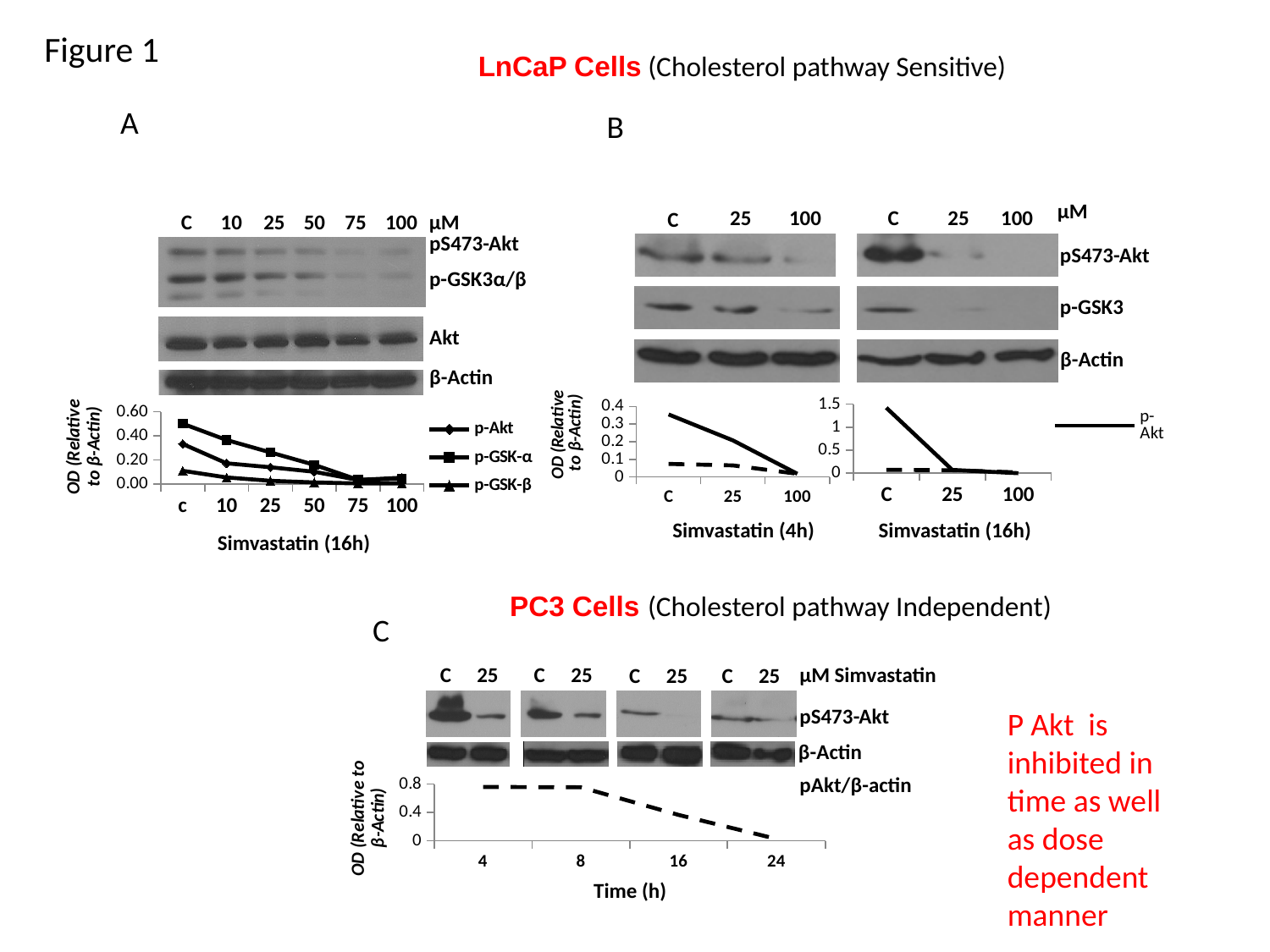
In the Panel B Simvastatin (4h) chart, is the value of the solid p-Akt line at C greater or less than 0.3? greater In the Panel A chart (Simvastatin (16h)), which series has the highest value at c? p-GSK-α In the Panel A chart (Simvastatin (16h)), how many categories are shown on the x axis? 6 In the Panel A chart (Simvastatin (16h)), is the value for p-GSK-α at c greater or less than 0.40? greater In the Panel B Simvastatin (16h) chart, is the value of the solid p-Akt line at C greater or less than 1? greater In the Panel A chart (Simvastatin (16h)), how many series does the legend list? 3 In the Panel A chart (Simvastatin (16h)), which series has the lowest value at c? p-GSK-β In the Panel A chart (Simvastatin (16h)), do the values for p-Akt rise or fall from c to 100? fall In the Panel C chart (Time (h)), how many time points are plotted on the x axis? 4 What kind of chart is the Panel A chart (Simvastatin (16h))? line chart In the Panel B Simvastatin (4h) chart, how many categories are shown on the x axis? 3